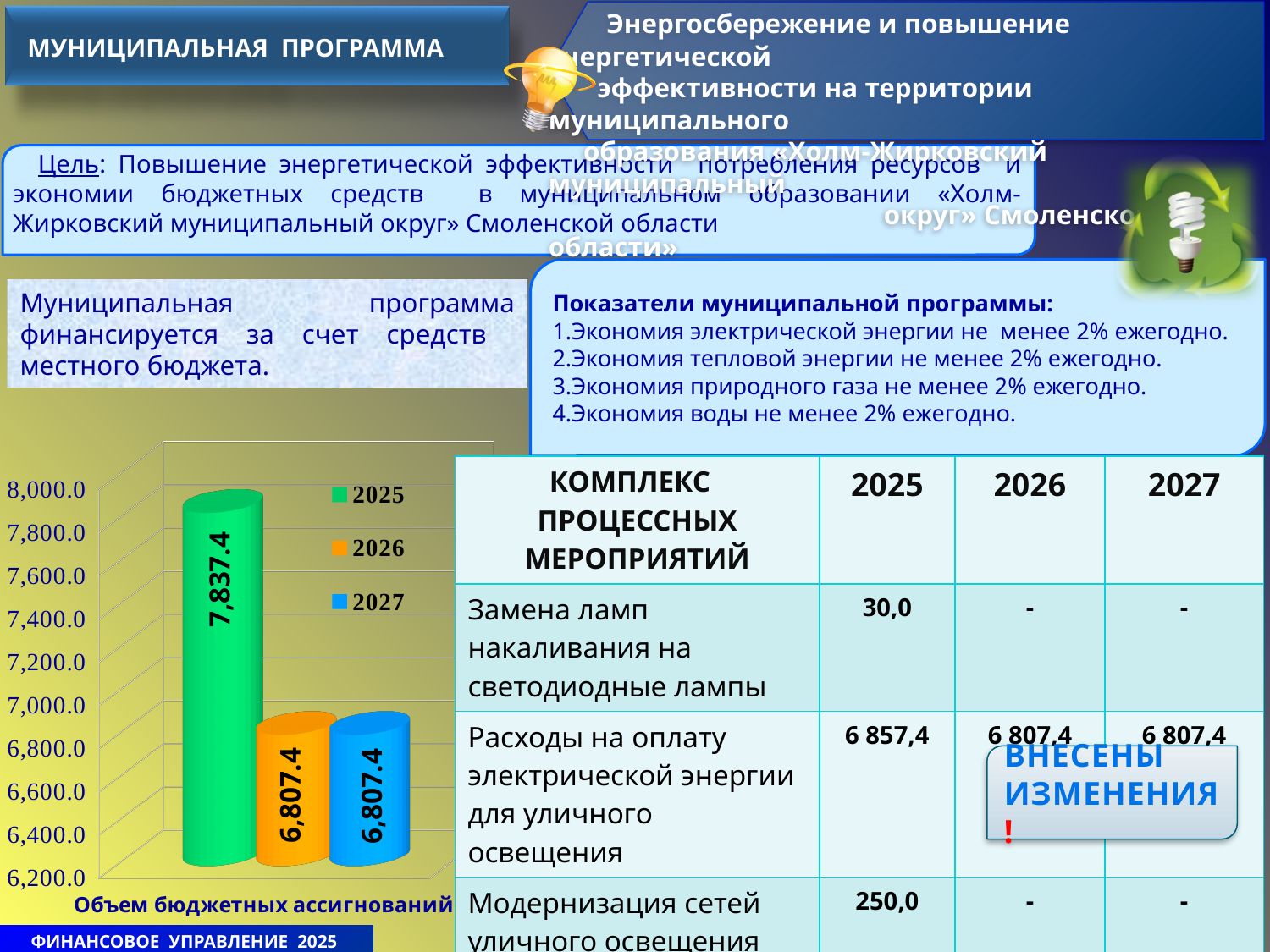
What is the value shown for 2026 in the chart? 6,807.4 Is the value for 2026 in the chart greater or less than 7,000.0? less How many bars are plotted in the chart? 3 What is the value shown for 2025 in the chart? 7,837.4 Which is larger in the chart, the value for 2025 or the value for 2027? 2025 Which year has the highest value in the chart? 2025 Is the value for 2025 in the chart greater or less than 7,600.0? greater What is the difference between the 2025 value and the 2026 value in the chart? 1,030.0 What is the value shown for 2027 in the chart? 6,807.4 What colour is the bar for 2026 in the chart? orange What kind of chart is shown on the slide? bar chart How many entries does the chart legend list? 3